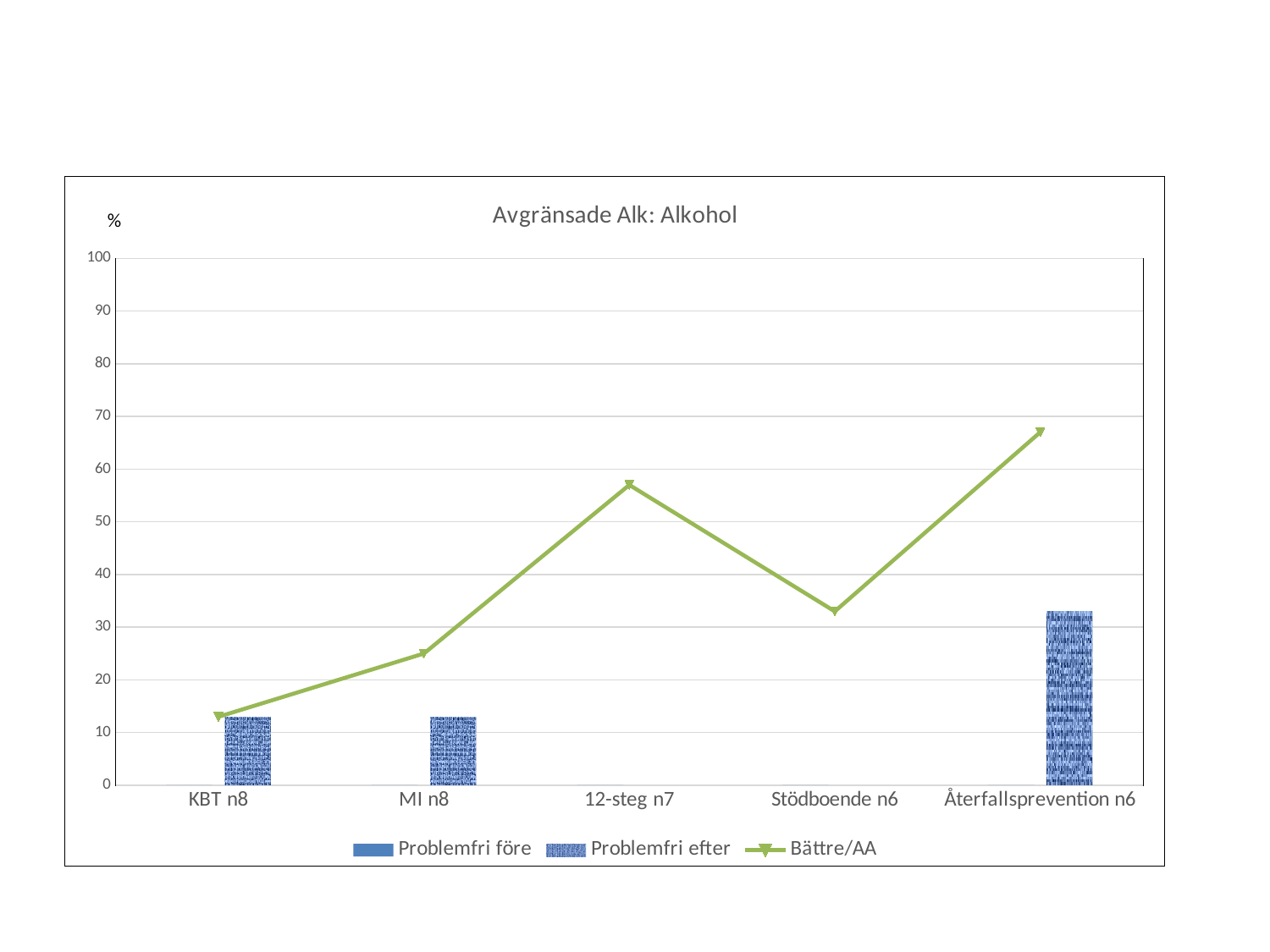
Is the Bättre/AA value for Återfallsprevention n6 greater or less than 60? greater Which category has the highest Problemfri efter bar? Återfallsprevention n6 Is the Bättre/AA value for Stödboende n6 greater or less than 40? less Which category has the highest value for the Bättre/AA line? Återfallsprevention n6 Which category has the lowest value for the Bättre/AA line? KBT n8 Which is larger for the Bättre/AA line: 12-steg n7 or Stödboende n6? 12-steg n7 Is the Bättre/AA value for 12-steg n7 greater or less than 50? greater What is the title of the chart? Avgränsade Alk: Alkohol How many categories are shown on the x axis? 5 How many series does the legend list? 3 Does the Bättre/AA line rise or fall from Stödboende n6 to Återfallsprevention n6? rise